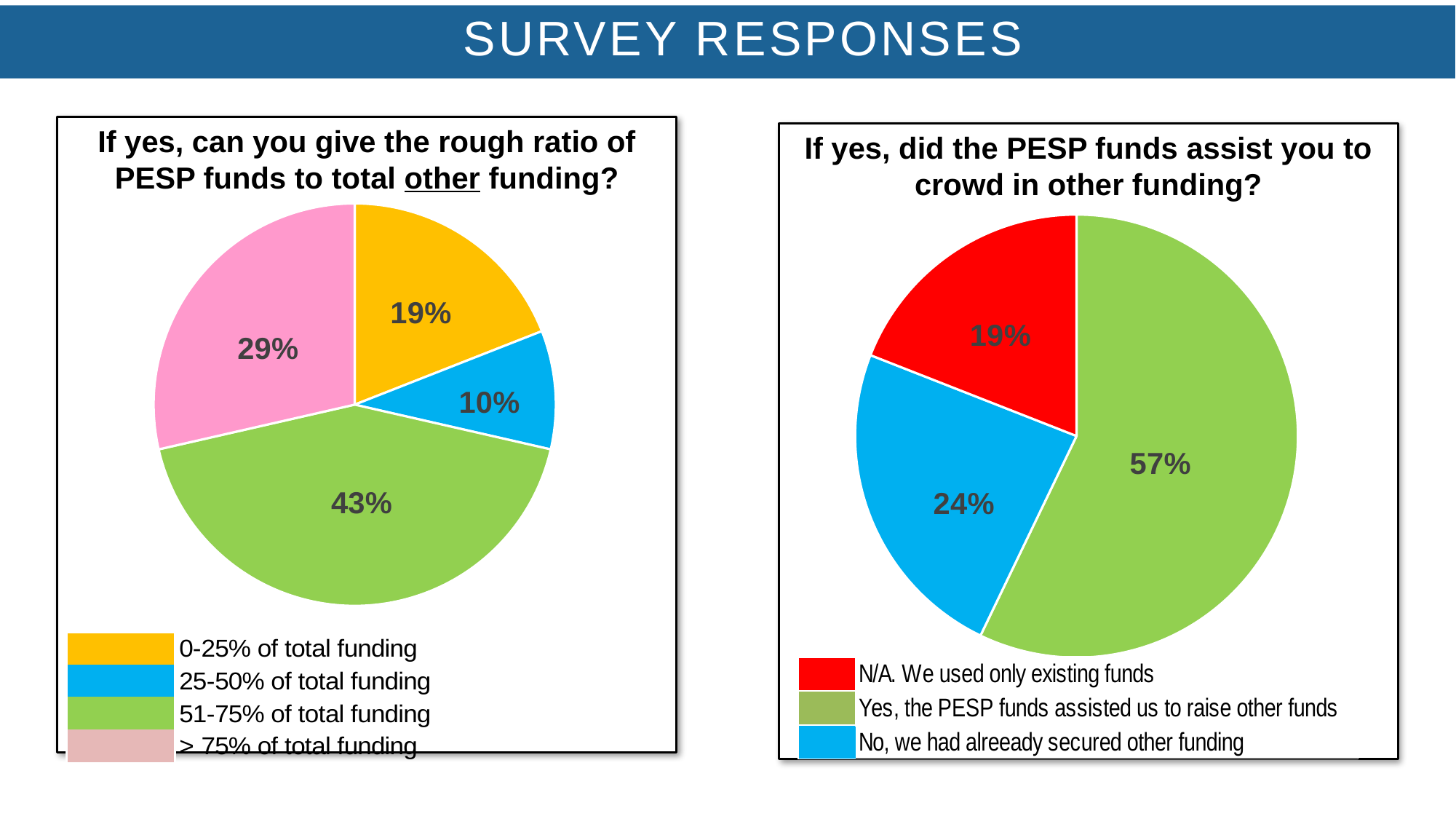
In the right chart (did the PESP funds assist you to crowd in other funding), which response has the smallest slice? N/A. We used only existing funds In the left chart (ratio of PESP funds to total other funding), how many categories does the legend list? 4 In the left chart (ratio of PESP funds to total other funding), which category has the largest slice? 51-75% of total funding In the left chart (ratio of PESP funds to total other funding), which category has the smallest slice? 25-50% of total funding In the right chart (did the PESP funds assist you to crowd in other funding), what share of responses is 'No, we had alreeady secured other funding'? 24% In the right chart (did the PESP funds assist you to crowd in other funding), what share of responses is 'Yes, the PESP funds assisted us to raise other funds'? 57% In the right chart (did the PESP funds assist you to crowd in other funding), which is larger: the 'No, we had alreeady secured other funding' slice or the 'N/A. We used only existing funds' slice? No, we had alreeady secured other funding In the left chart (ratio of PESP funds to total other funding), what share of responses is '25-50% of total funding'? 10% In the left chart (ratio of PESP funds to total other funding), what share of responses is '51-75% of total funding'? 43% What type of chart is used on the right side of the slide? Pie chart In the right chart (did the PESP funds assist you to crowd in other funding), what colour is the 'Yes, the PESP funds assisted us to raise other funds' slice? Green In the left chart (ratio of PESP funds to total other funding), what is the difference between the '> 75% of total funding' slice and the '0-25% of total funding' slice? 10%